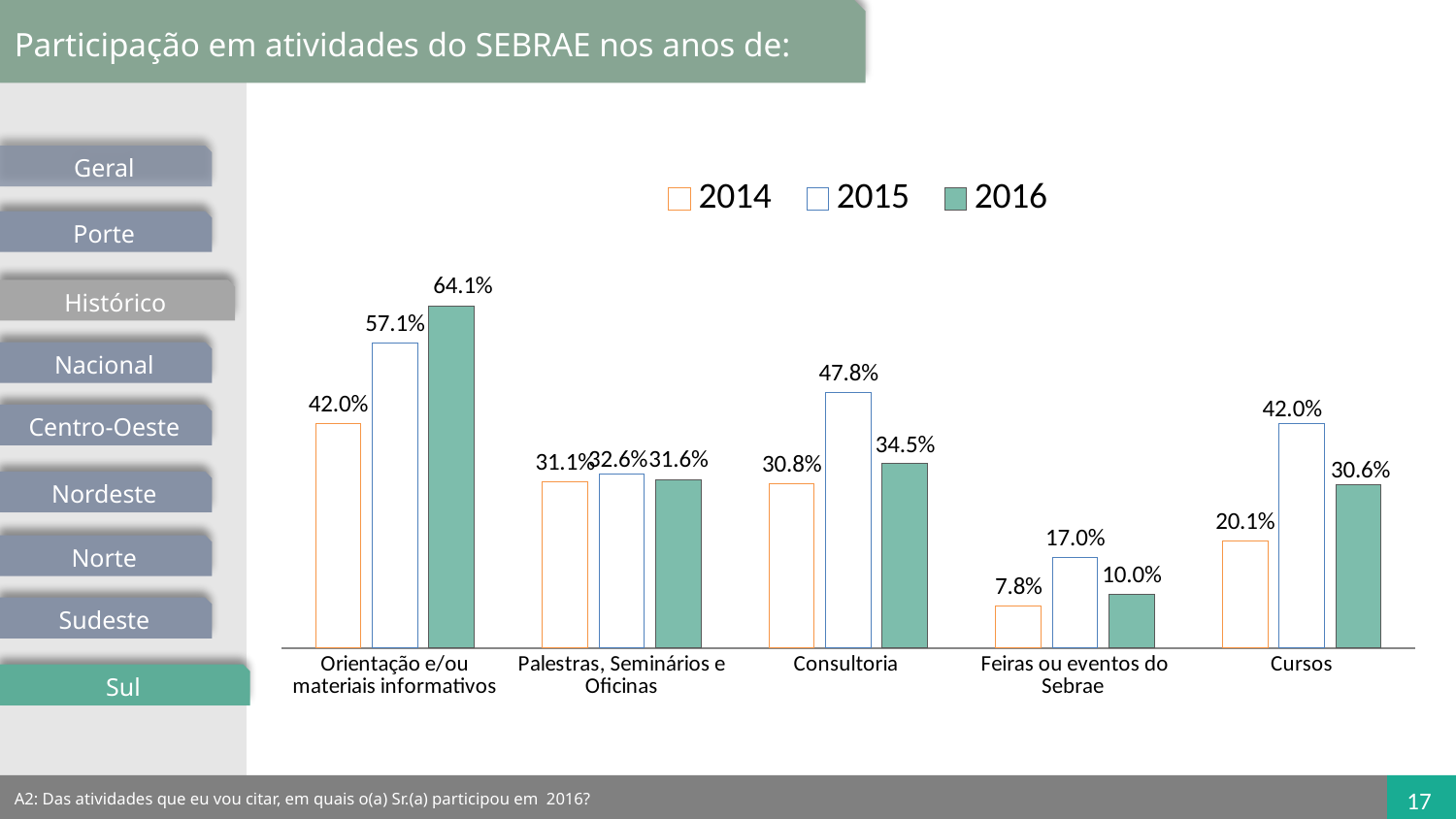
Which series is shown with filled green bars in the legend? 2016 Which category has the highest 2016 value? Orientação e/ou materiais informativos How many series does the legend list? 3 What is the 2014 value for Feiras ou eventos do Sebrae? 7.8% What is the 2016 value for Cursos? 30.6% What is the difference between the 2015 and 2014 values for Cursos? 21.9% What is the 2016 value for Orientação e/ou materiais informativos? 64.1% How many categories are shown on the x axis? 5 What is the 2015 value for Consultoria? 47.8% Which is larger for Consultoria: the 2015 value or the 2016 value? 2015 Which category has the lowest 2015 value? Feiras ou eventos do Sebrae What kind of chart is shown on the slide? bar chart